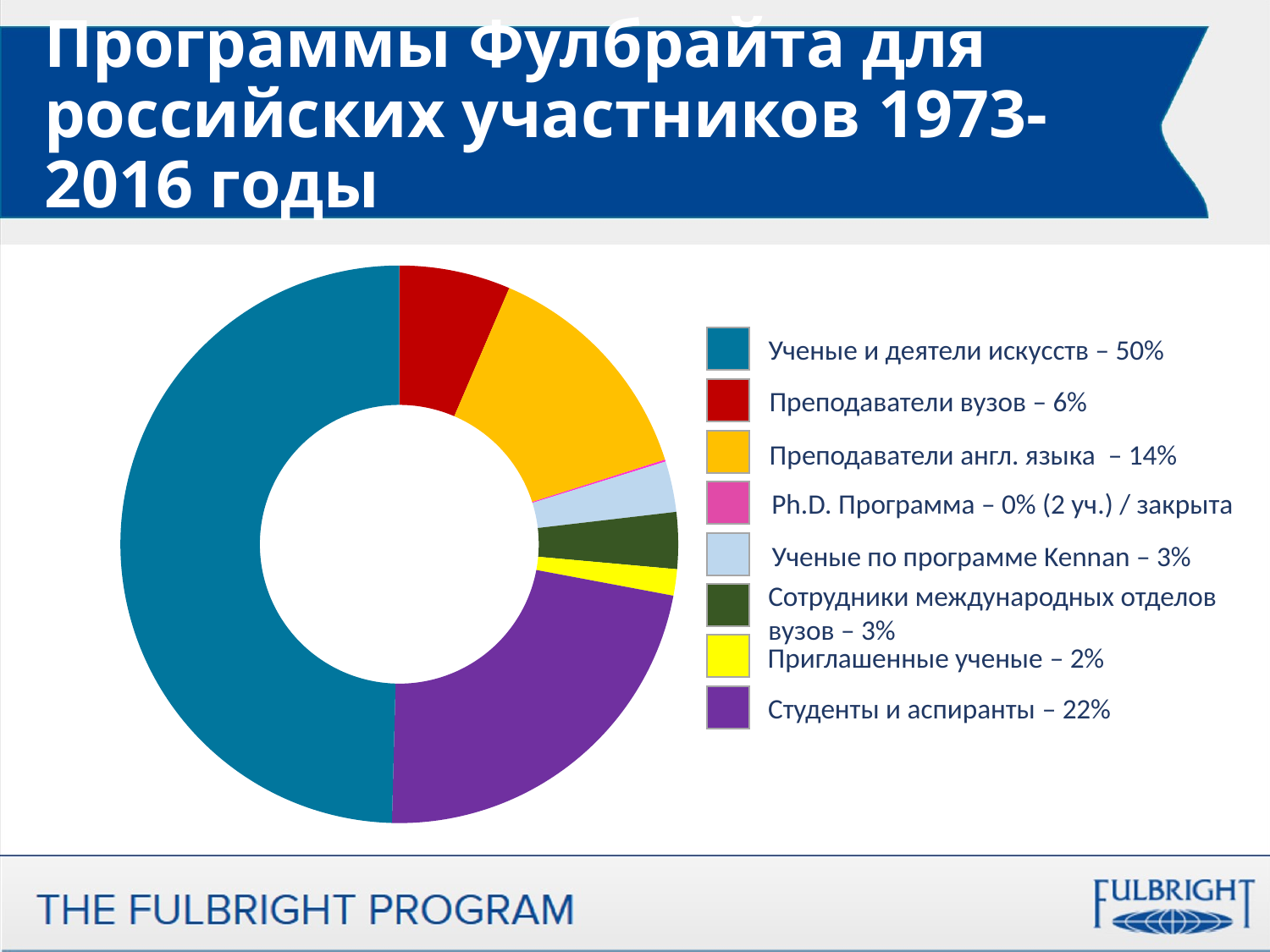
What percentage of participants are Ученые и деятели искусств? 50% What percentage is shown for Преподаватели англ. языка? 14% What is the difference in percentage points between Преподаватели англ. языка and Преподаватели вузов? 8 percentage points What kind of chart is shown on the slide? Doughnut chart What is the title of the slide? Программы Фулбрайта для российских участников 1973-2016 годы Which category has the smallest share of the pie? Ph.D. Программа What percentage is shown for Ученые по программе Kennan? 3% What percentage of participants are Студенты и аспиранты? 22% Which category has the largest share of the pie? Ученые и деятели искусств How many categories does the legend list? 8 Which is larger: the share for Преподаватели вузов or the share for Приглашенные ученые? Преподаватели вузов What is the difference in percentage points between Ученые и деятели искусств and Студенты и аспиранты? 28 percentage points